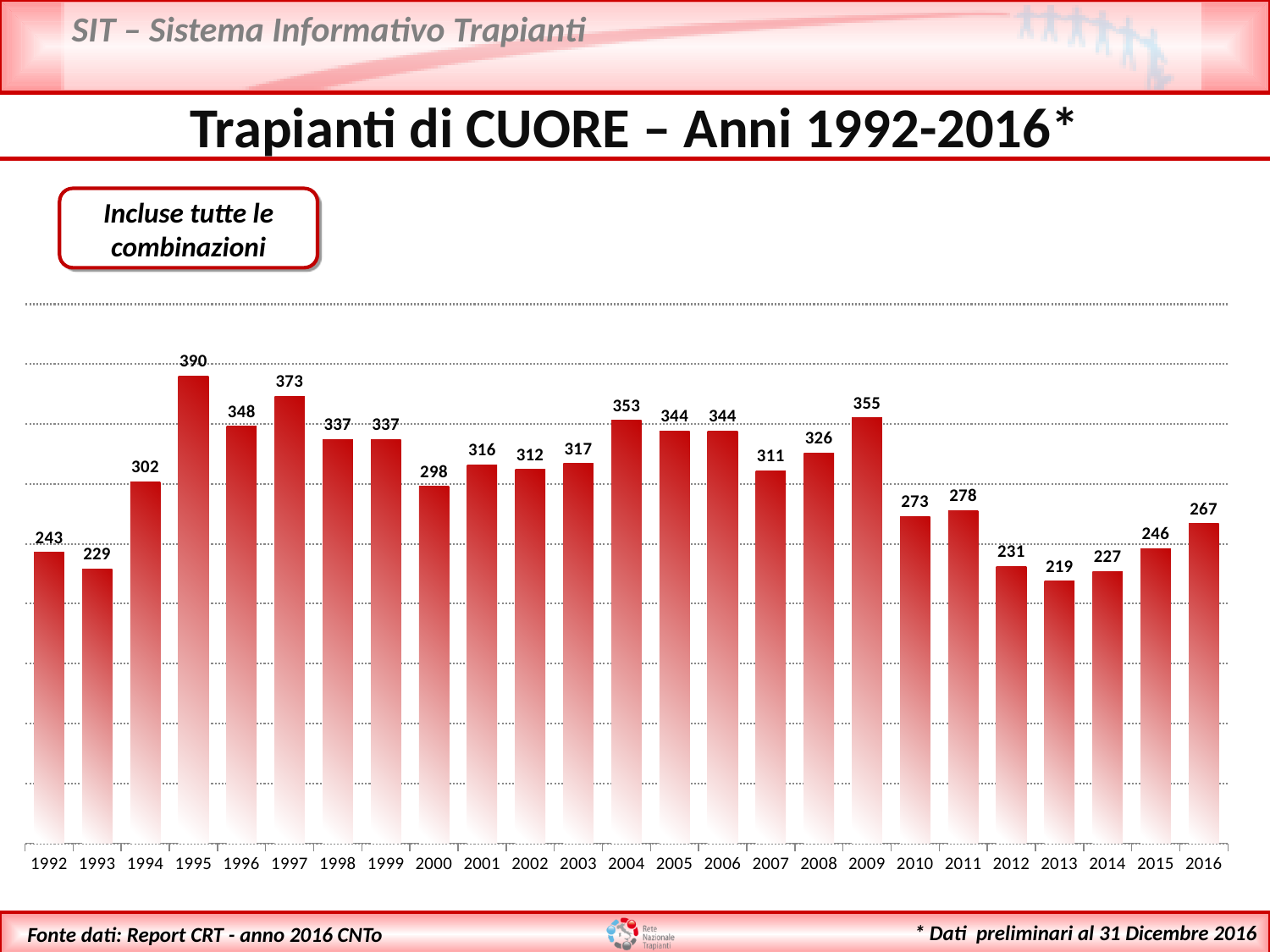
How many years are shown on the x axis? 25 Which year has the lowest value? 2013 Which is larger, the value for 1997 or the value for 2004? 1997 What is the value for 1995? 390 What is the difference between the values for 1995 and 2013? 171 What kind of chart is shown on the slide? bar chart Which year has the highest value? 1995 What is the difference between the values for 2016 and 2015? 21 What is the value for 2016? 267 What is the value for 2009? 355 Which is larger, the value for 2010 or the value for 2011? 2011 Do the values rise or fall from 2013 to 2016? rise